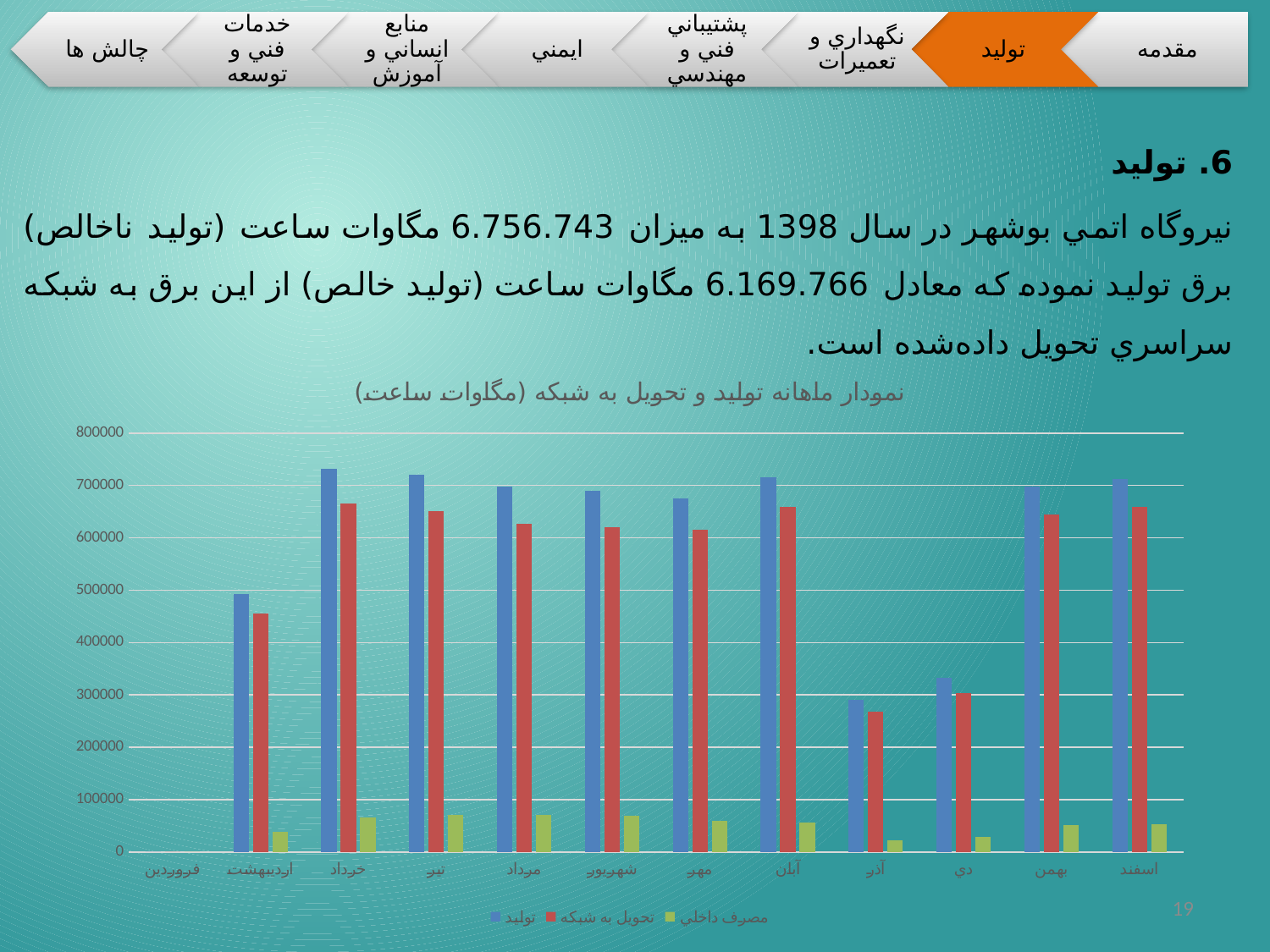
In خرداد, which is larger: تولید or تحویل به شبکه? تولید Which is larger: تولید in دی or تولید in بهمن? بهمن Is the value for تولید in آذر greater or less than 300000? less How many series does the chart legend list? 3 Is the value for تحویل به شبکه in اردیبهشت greater or less than 500000? less What is the title of the chart? نمودار ماهانه تولید و تحویل به شبکه (مگاوات ساعت) Is the value for مصرف داخلی in تیر greater or less than 100000? less Does the value for تولید rise or fall from آبان to آذر? fall What kind of chart is shown on the slide? bar chart How many months (categories) are shown on the x axis of the chart? 12 Which month has the lowest value for تولید in the chart? فروردین